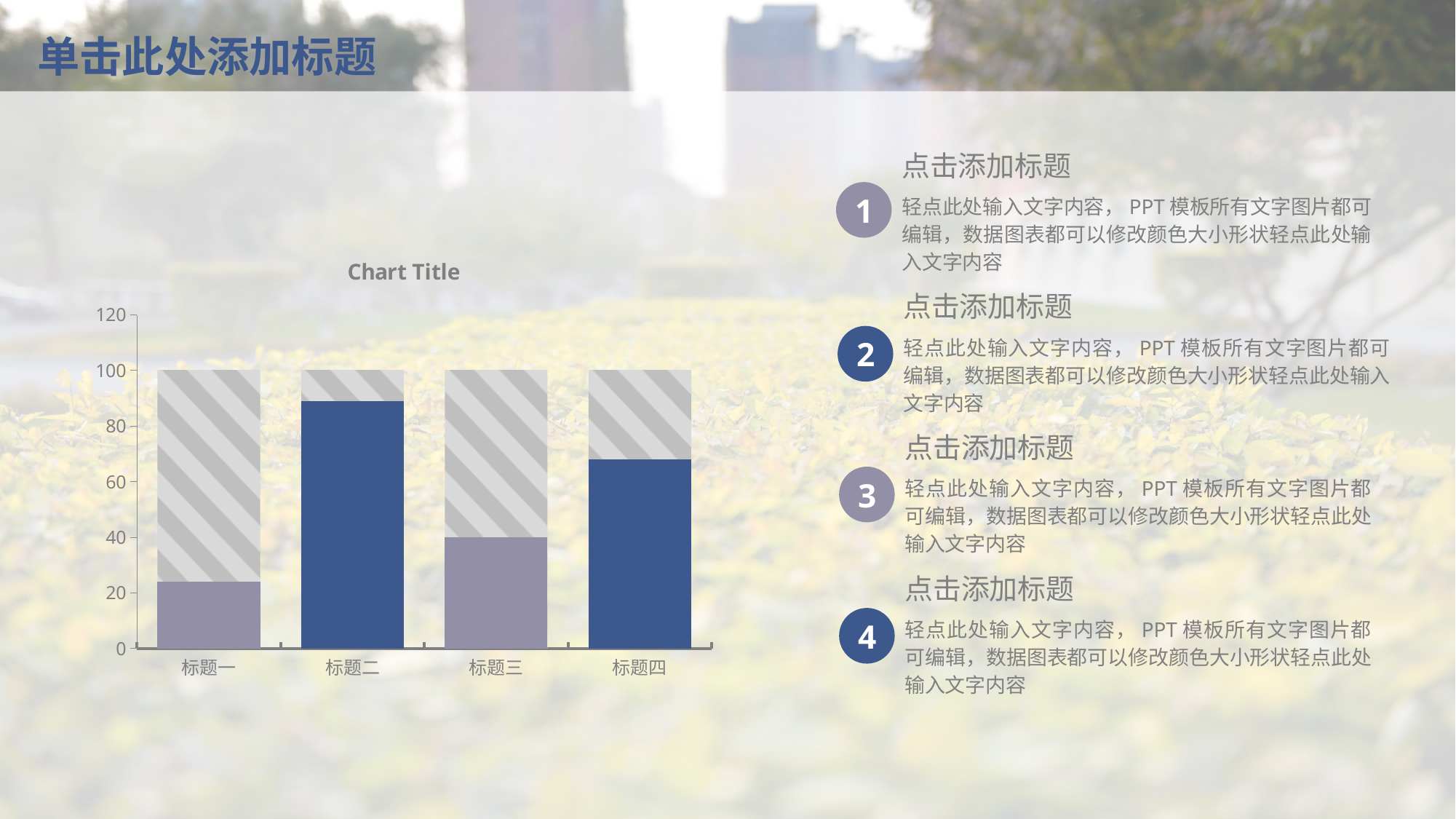
Is the lower segment value for 标题一 greater or less than 40? less Which category has the shortest lower (coloured) segment? 标题一 What is the value of the lower (coloured) segment for 标题三? 40 Is the lower segment value for 标题二 greater or less than 80? greater Which category has the tallest lower (coloured) segment? 标题二 Is the lower segment value for 标题四 greater or less than 60? greater What is the highest value shown on the vertical axis? 120 What kind of chart is shown on the slide? bar chart What is the total height of the stacked bar for 标题一? 100 Which has the larger lower segment, 标题三 or 标题四? 标题四 How many categories are shown on the x axis of the chart? 4 What is the title of the chart? Chart Title